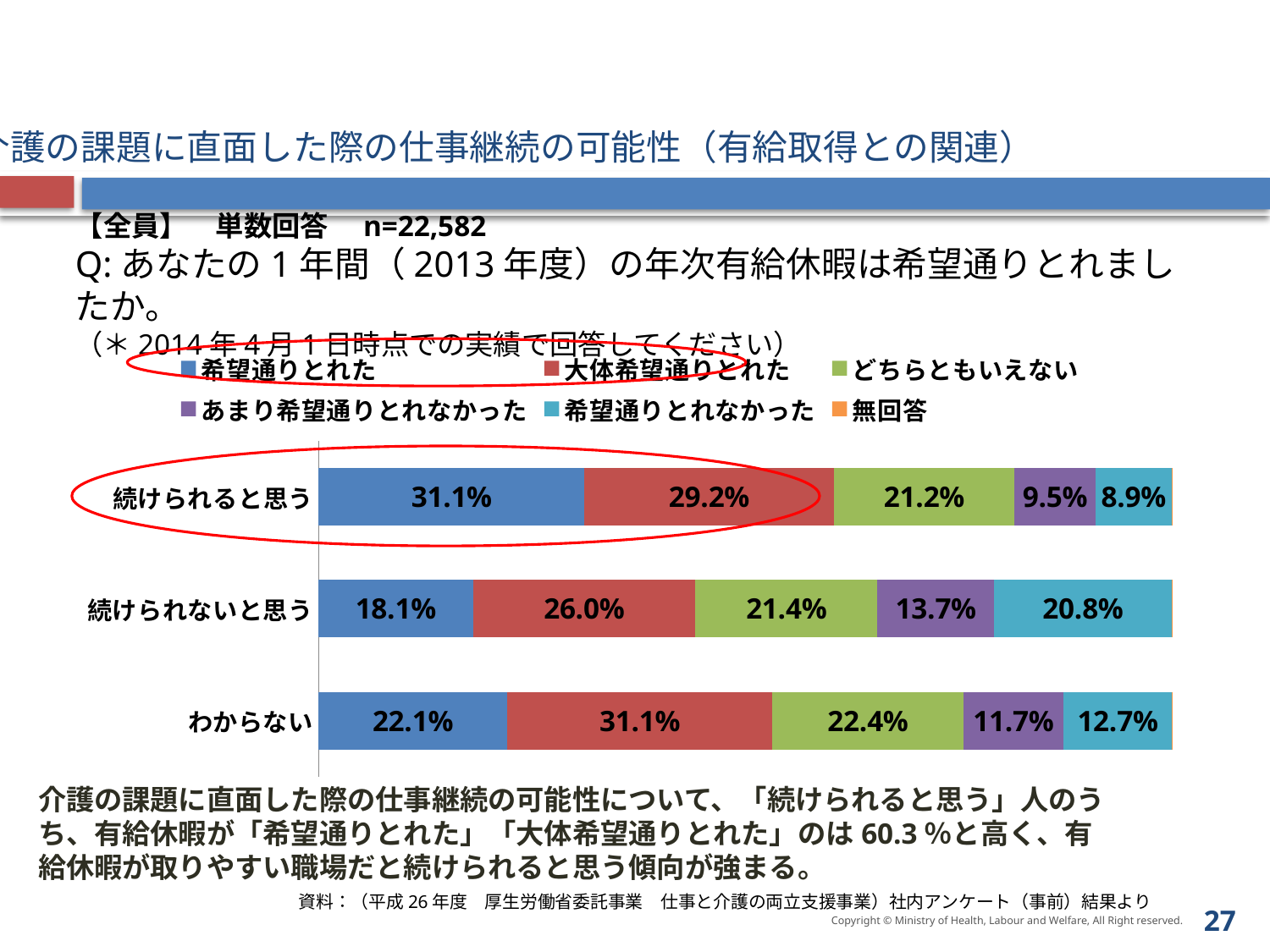
Which category has the highest value for 希望通りとれた? 続けられると思う What is the value of 希望通りとれた for 続けられると思う? 31.1% Which is larger: 希望通りとれなかった for 続けられないと思う or for わからない? 続けられないと思う What kind of chart is shown on the slide? Stacked bar chart Which category has the lowest value for 希望通りとれなかった? 続けられると思う What is the value of 大体希望通りとれた for 続けられないと思う? 26.0% What is the difference between 希望通りとれた for 続けられると思う and for 続けられないと思う? 13.0% What is the value of あまり希望通りとれなかった for 続けられると思う? 9.5% What is the value of 希望通りとれなかった for わからない? 12.7% How many series does the legend list? 6 How many categories (bars) does the chart show? 3 What is the n (sample size) shown above the chart? n=22,582